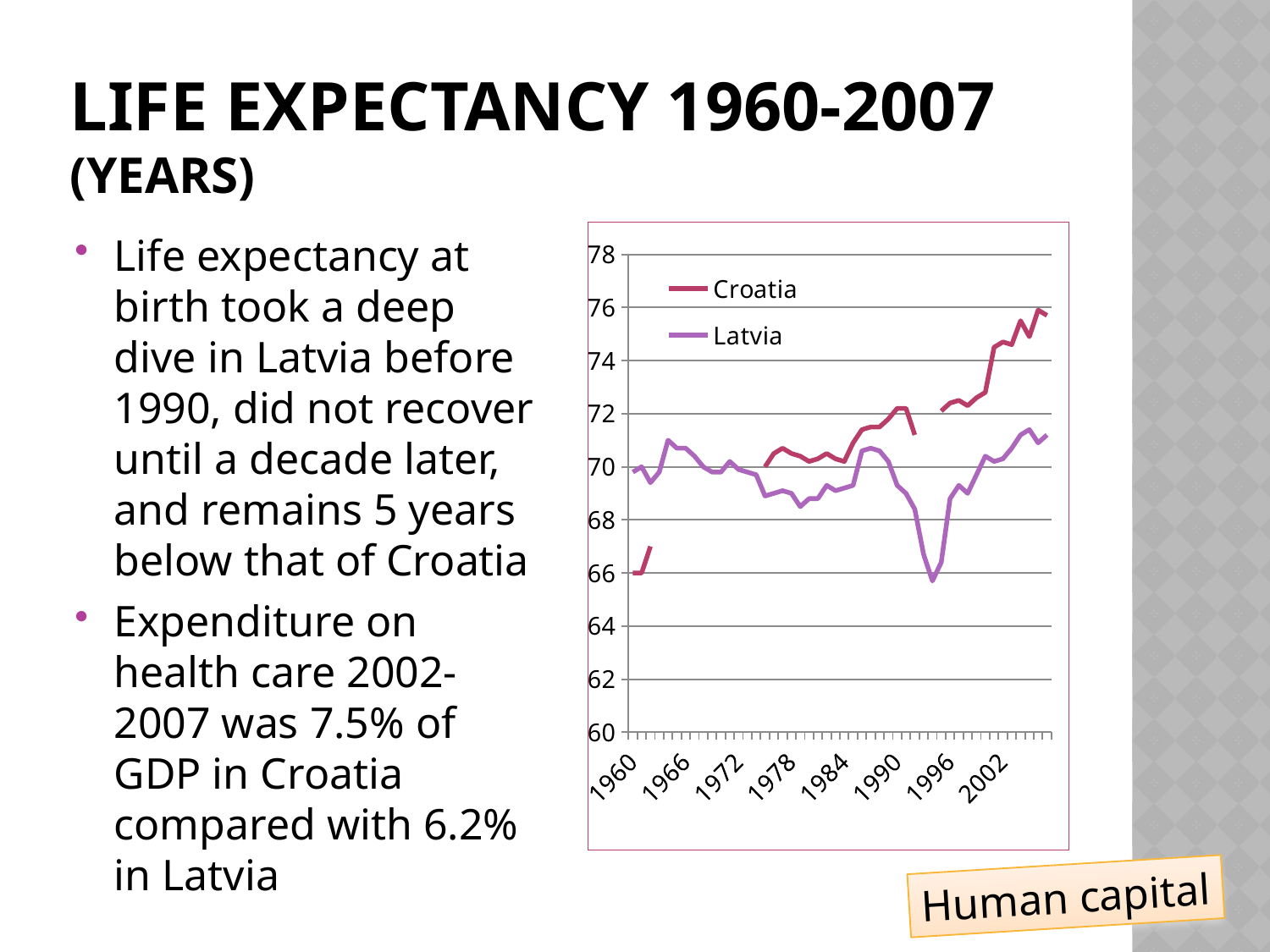
Is the value for Latvia in 1978 greater or less than 70? less Is the value for Latvia in 2007 greater or less than 70? greater Is the value for Croatia in 2007 greater or less than 74? greater How many series does the chart legend list? 2 Which country has the higher life expectancy in 2007? Croatia Does the Croatia line rise or fall between 1996 and 2007? rises Which series is drawn in purple? Latvia What kind of chart is shown on the slide? line chart Which country's line reaches the lowest value on the chart? Latvia Which two countries are shown in the chart legend? Croatia and Latvia